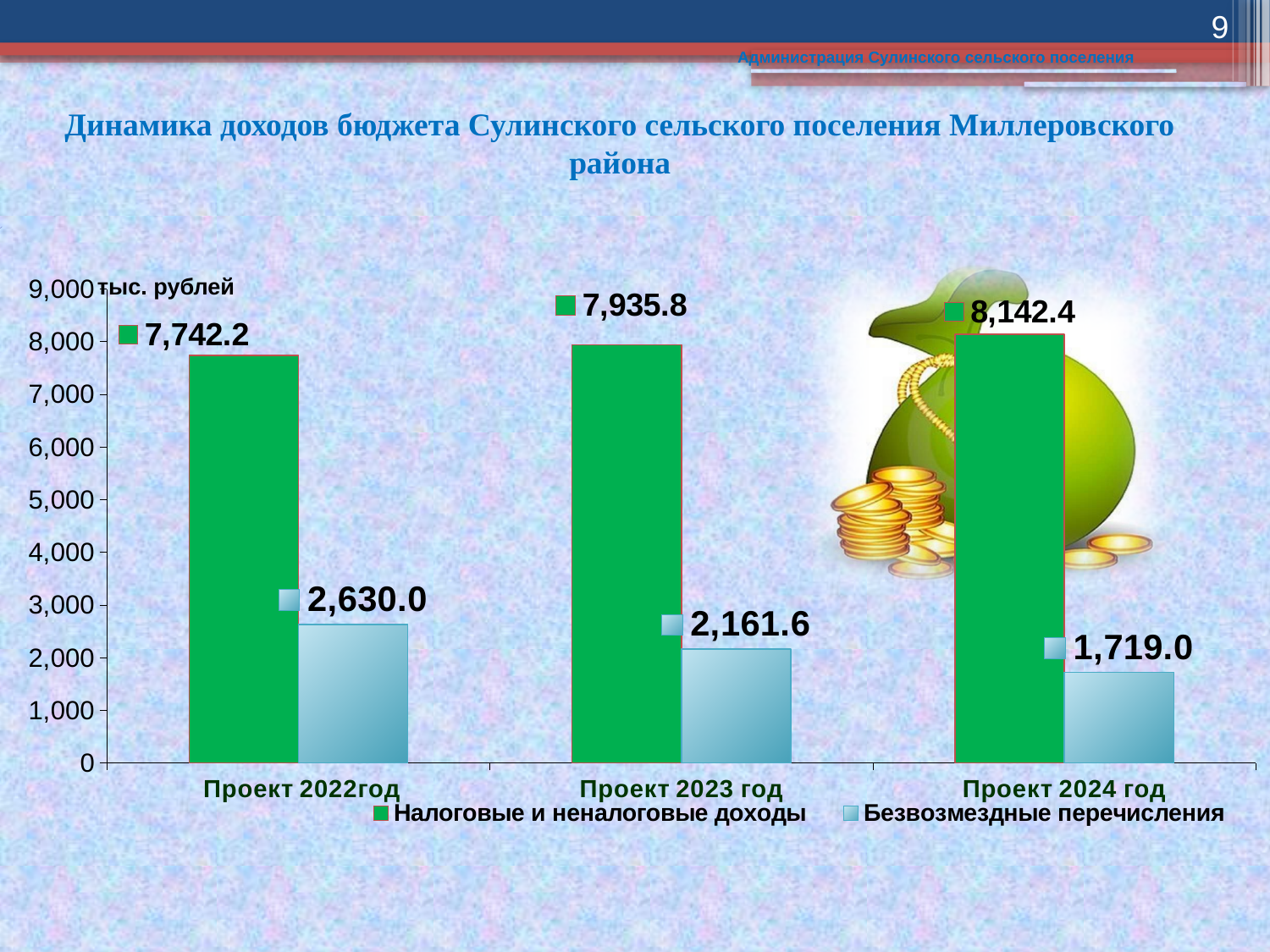
What is the value of Безвозмездные перечисления for Проект 2022год? 2,630.0 How many categories are shown on the x axis? 3 How many series does the legend list? 2 Which category has the highest value for Налоговые и неналоговые доходы? Проект 2024 год What is the difference between Налоговые и неналоговые доходы for Проект 2024 год and Проект 2022год? 400.2 What is the value of Налоговые и неналоговые доходы for Проект 2023 год? 7,935.8 Do the values for Безвозмездные перечисления rise or fall from Проект 2022год to Проект 2024 год? Fall Which is larger: Безвозмездные перечисления for Проект 2022год or for Проект 2023 год? Проект 2022год What unit is indicated at the top of the vertical axis? тыс. рублей What kind of chart is shown on the slide? Bar chart What is the value of Безвозмездные перечисления for Проект 2024 год? 1,719.0 Which category has the lowest value for Безвозмездные перечисления? Проект 2024 год